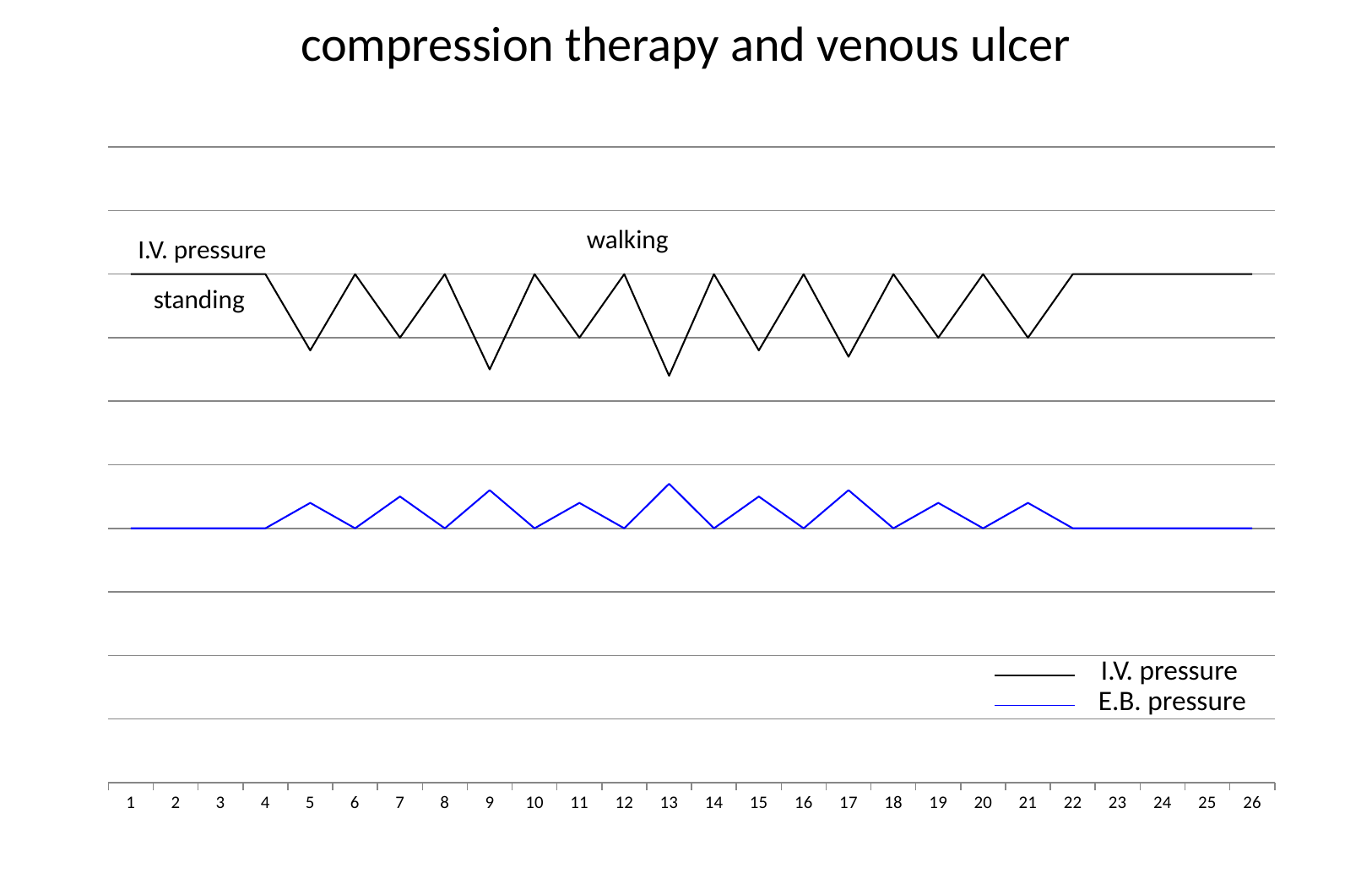
What is the title of the chart? compression therapy and venous ulcer Which series is plotted higher on the chart, I.V. pressure or E.B. pressure? I.V. pressure How many points are labelled along the x axis? 26 Does the I.V. pressure line rise, fall or stay flat between x-axis points 1 and 4? stay flat Does the E.B. pressure line rise, fall or stay flat between x-axis points 22 and 26? stay flat What are the two series named in the legend? I.V. pressure and E.B. pressure At which x-axis point does the E.B. pressure line reach its highest value? 13 At which x-axis point does the I.V. pressure line reach its lowest value? 13 Does the I.V. pressure line rise or fall between x-axis points 4 and 5? fall What kind of chart is shown on the slide? line chart How many series does the legend list? 2